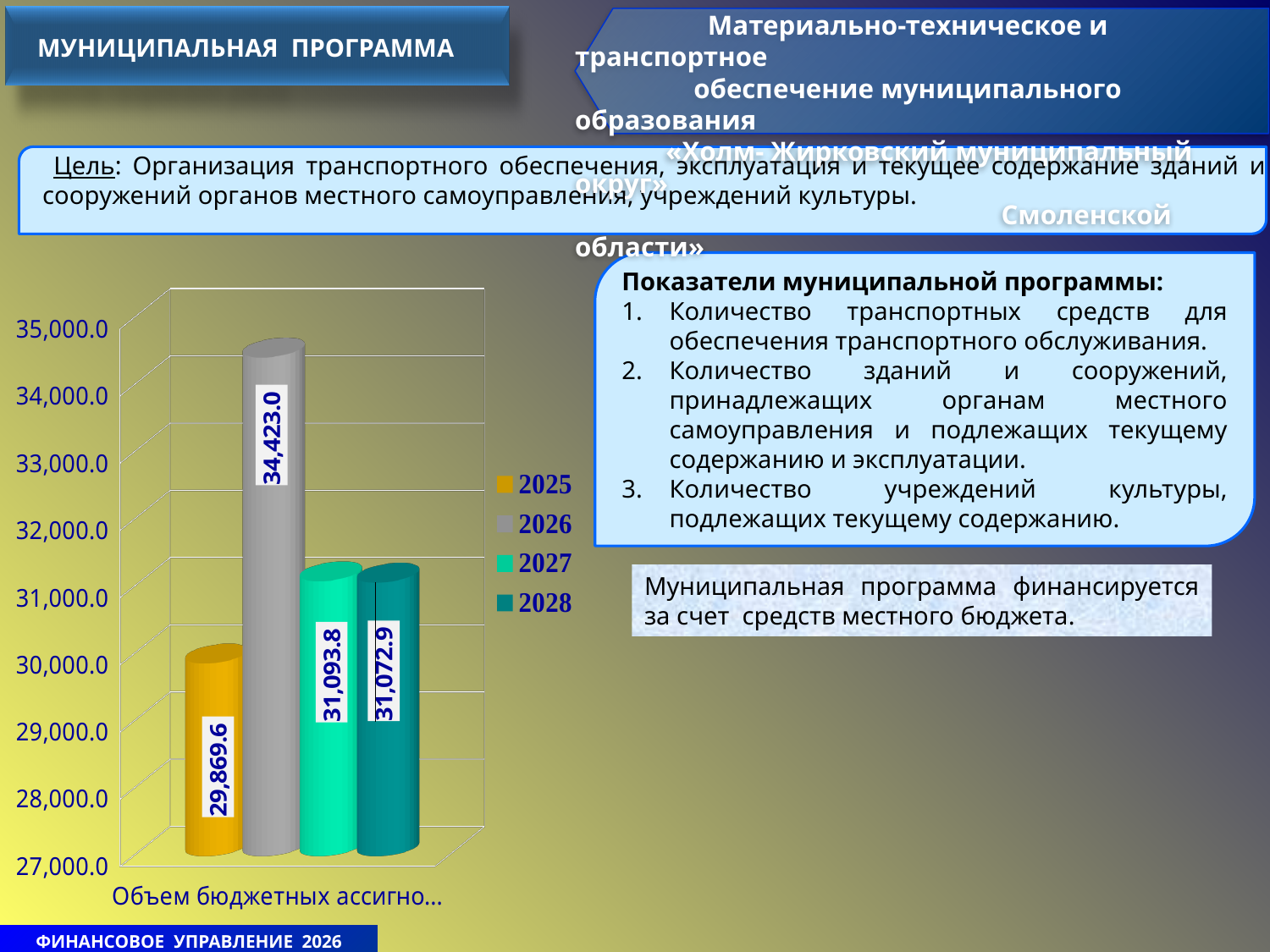
Is the value for 2025 greater or less than 30,000.0? less Which year has the lowest value in the bar chart? 2025 What is the value for 2027 in the bar chart? 31,093.8 What is the difference between the values for 2026 and 2025? 4,553.4 What is the value for 2025 in the bar chart? 29,869.6 What is the value for 2028 in the bar chart? 31,072.9 How many series does the legend of the bar chart list? 4 What kind of chart is shown on the slide? bar chart Which year has the highest value in the bar chart? 2026 Which is larger, the value for 2025 or the value for 2026? 2026 What is the difference between the values for 2026 and 2027? 3,329.2 What is the value for 2026 in the bar chart? 34,423.0